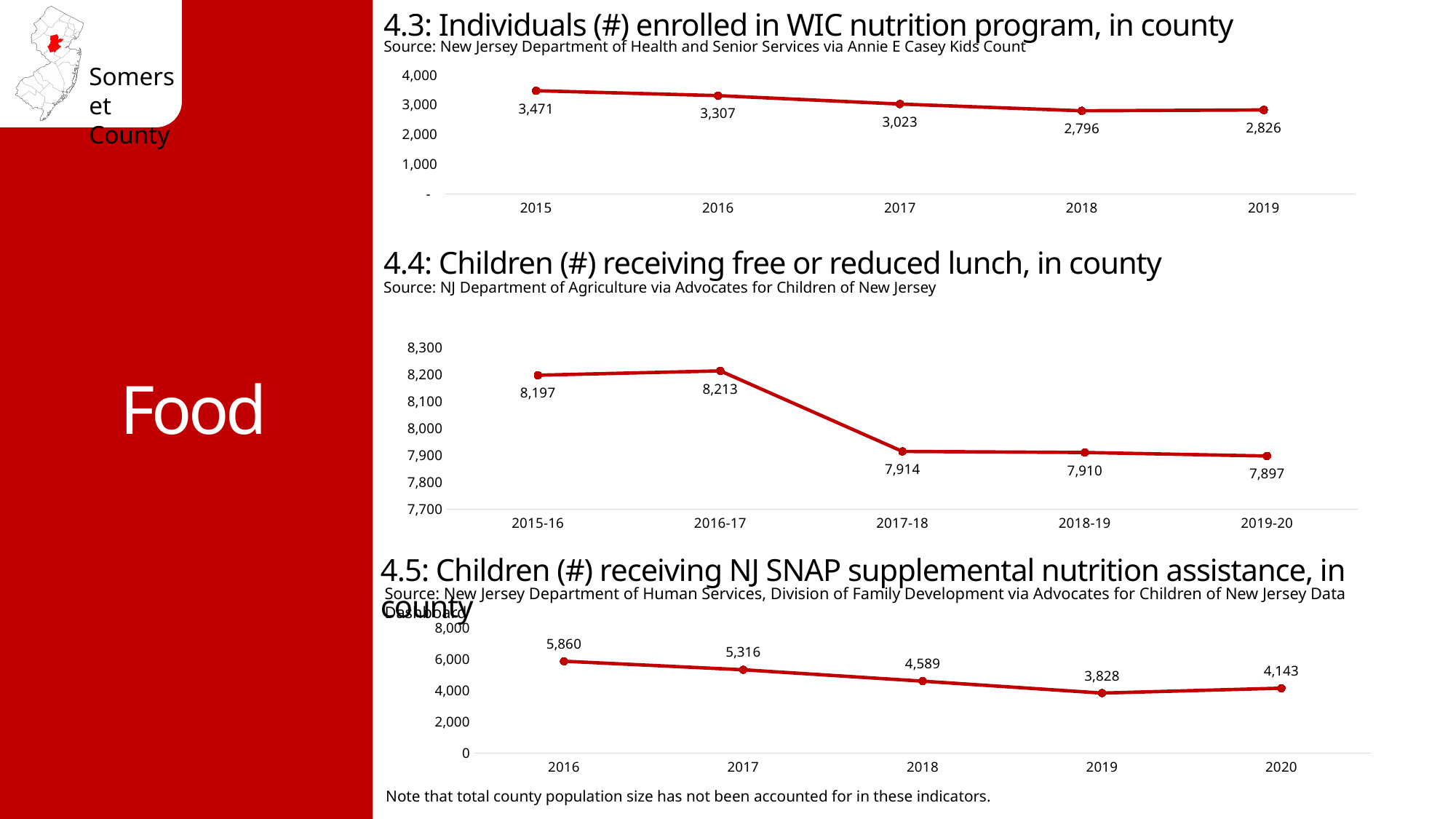
In the chart '4.4: Children (#) receiving free or reduced lunch, in county', which school year has the highest value? 2016-17 In the chart '4.5: Children (#) receiving NJ SNAP supplemental nutrition assistance, in county', which year has the highest value? 2016 In the chart '4.4: Children (#) receiving free or reduced lunch, in county', what is the value for 2016-17? 8,213 In the chart '4.5: Children (#) receiving NJ SNAP supplemental nutrition assistance, in county', what is the value for 2019? 3,828 In the chart '4.5: Children (#) receiving NJ SNAP supplemental nutrition assistance, in county', is the value for 2020 larger or smaller than the value for 2017? Smaller In the chart '4.4: Children (#) receiving free or reduced lunch, in county', what is the difference between the 2016-17 and 2017-18 values? 299 In the chart '4.3: Individuals (#) enrolled in WIC nutrition program, in county', which year has the lowest value? 2018 In the chart '4.5: Children (#) receiving NJ SNAP supplemental nutrition assistance, in county', do the values generally rise or fall from 2016 to 2019? Fall What kind of chart is '4.4: Children (#) receiving free or reduced lunch, in county'? Line chart In the chart '4.3: Individuals (#) enrolled in WIC nutrition program, in county', what is the difference between the 2015 and 2019 values? 645 In the chart '4.3: Individuals (#) enrolled in WIC nutrition program, in county', how many data points are plotted? 5 In the chart '4.3: Individuals (#) enrolled in WIC nutrition program, in county', what is the value for 2017? 3,023